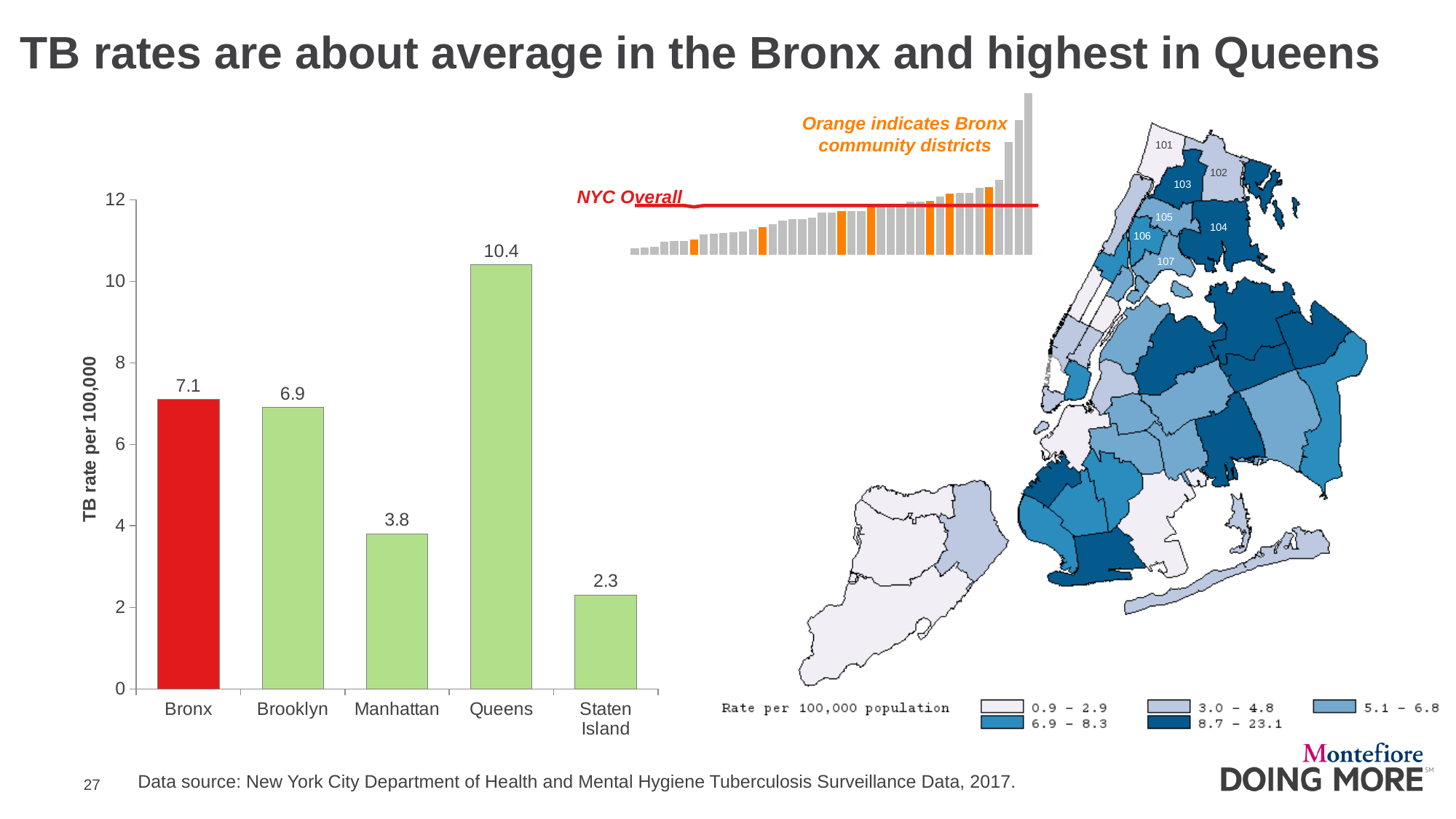
In the bar chart on the left, what is the TB rate per 100,000 for the Bronx? 7.1 In the bar chart on the left, what is the TB rate per 100,000 for Queens? 10.4 In the bar chart on the left, what is the TB rate per 100,000 for Manhattan? 3.8 In the bar chart on the left, which borough has the highest TB rate? Queens How many boroughs are shown in the bar chart on the left? 5 In the bar chart on the left, what is the difference between the TB rates of Queens and the Bronx? 3.3 In the bar chart on the left, what is the TB rate per 100,000 for Staten Island? 2.3 In the bar chart on the left, what is the difference between the TB rates of Manhattan and Staten Island? 1.5 In the bar chart on the left, which borough has the lowest TB rate? Staten Island In the bar chart on the left, is the value for Queens greater or less than 10? greater In the bar chart on the left, which has a higher TB rate, Brooklyn or Manhattan? Brooklyn What kind of chart is the chart on the left of the slide? Bar chart